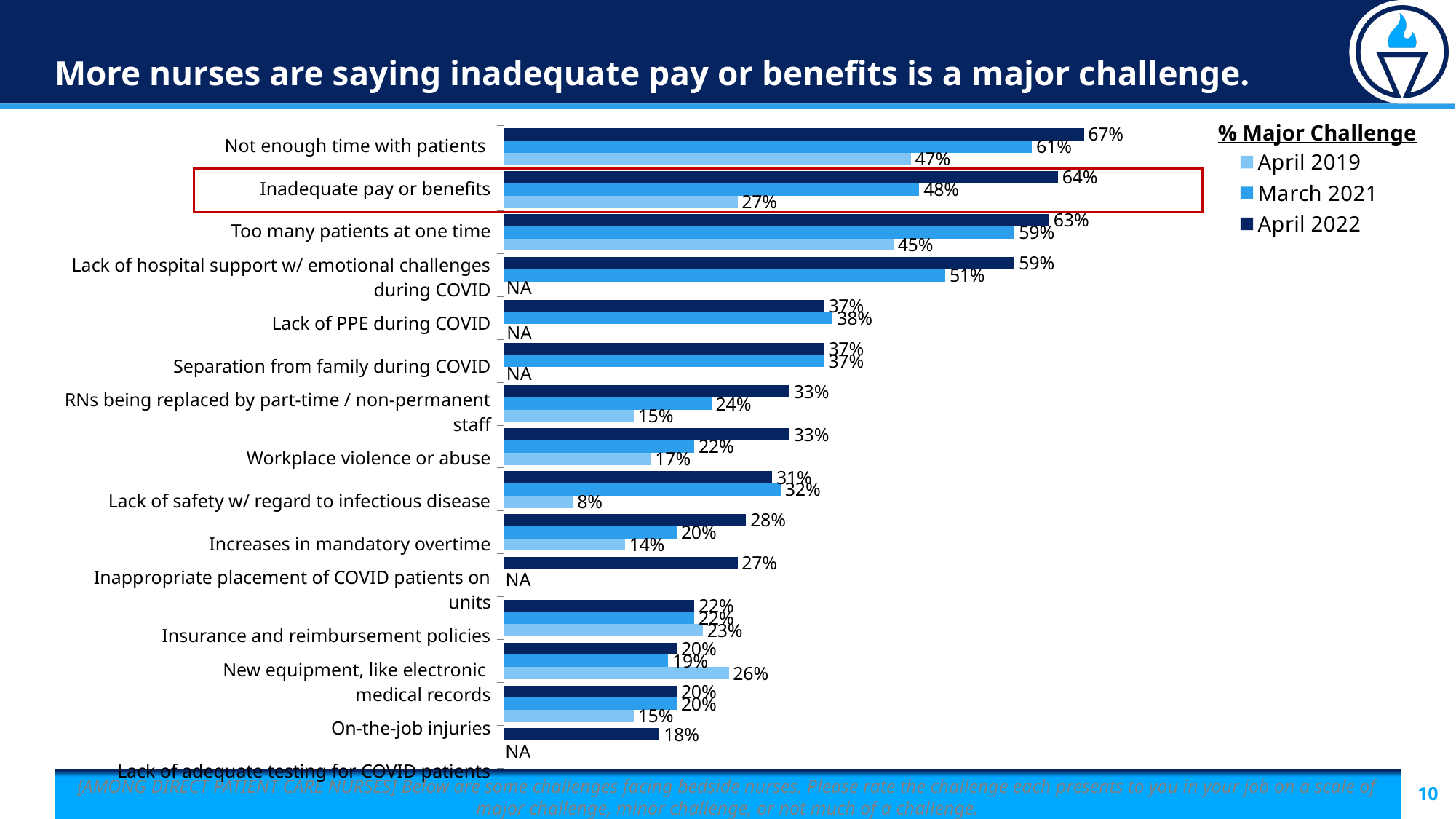
Which has the larger April 2022 value: 'Not enough time with patients' or 'Too many patients at one time'? Not enough time with patients What is the March 2021 value for 'Too many patients at one time'? 59% What is the difference between the April 2022 and April 2019 values for 'Inadequate pay or benefits'? 37 percentage points What is the April 2022 value for 'Inadequate pay or benefits'? 64% What kind of chart is shown on the slide? Bar chart Which category has the lowest April 2019 value? Lack of safety w/ regard to infectious disease Which category has the highest April 2022 value? Not enough time with patients How many series does the legend list? 3 What is the difference between the April 2022 and March 2021 values for 'Not enough time with patients'? 6 percentage points What is the April 2019 value for 'Inadequate pay or benefits'? 27% What is the April 2019 value for 'Lack of safety w/ regard to infectious disease'? 8% What heading appears above the legend? % Major Challenge